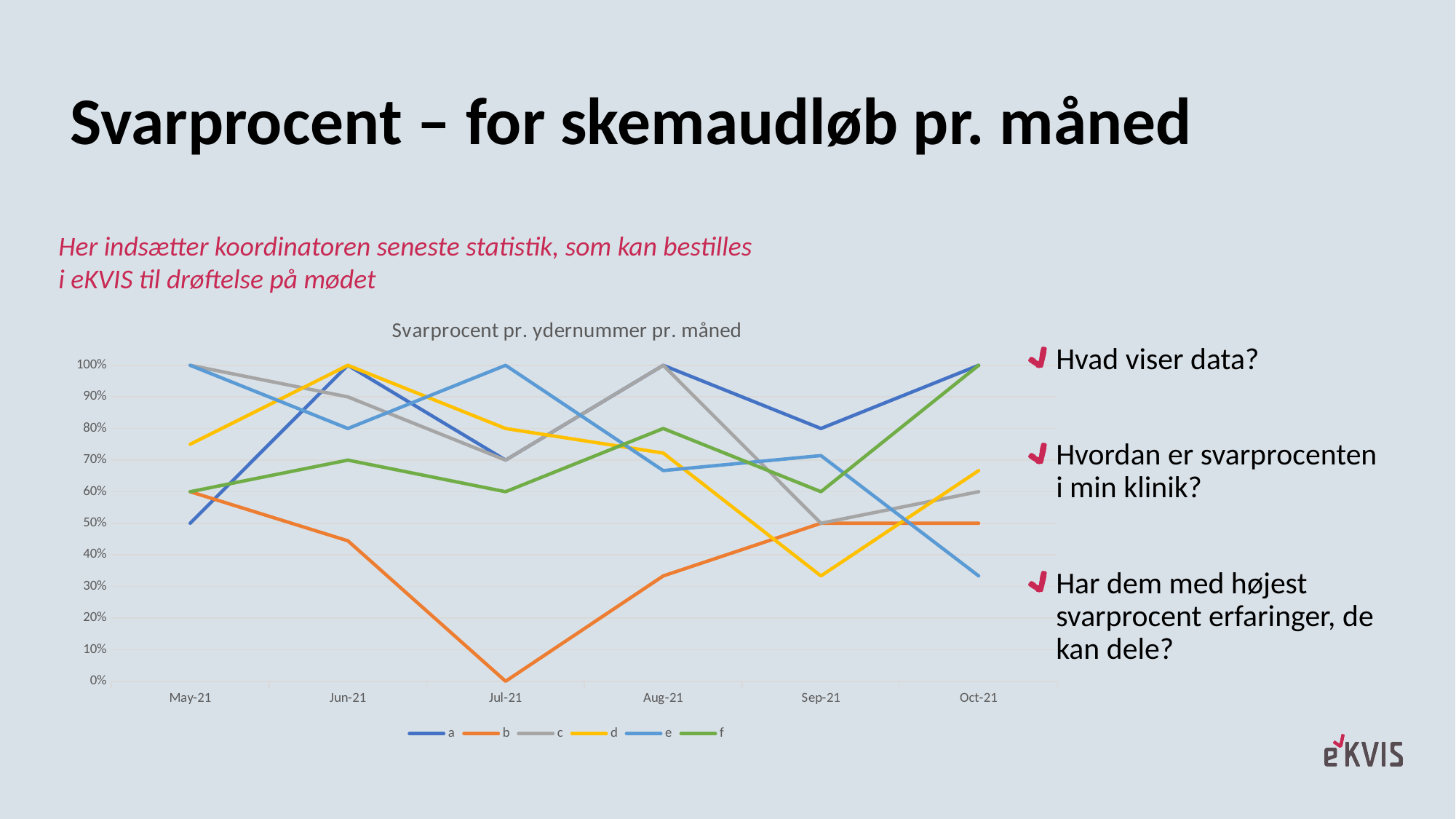
What is the value for series b in Jul-21? 0% How many series does the legend of the chart list? 6 Which is larger in Oct-21, the value for series a or the value for series e? a What is the title of the chart? Svarprocent pr. ydernummer pr. måned In which month does series b reach its lowest value? Jul-21 Does series b rise or fall from Jul-21 to Oct-21? rise What kind of chart is shown on the slide? line chart What is the value for series a in May-21? 50% What is the value for series f in Oct-21? 100% Is the value for series d in Sep-21 greater or less than 40%? less Which series has the lowest value in Jul-21? b How many months are shown on the x axis of the chart? 6